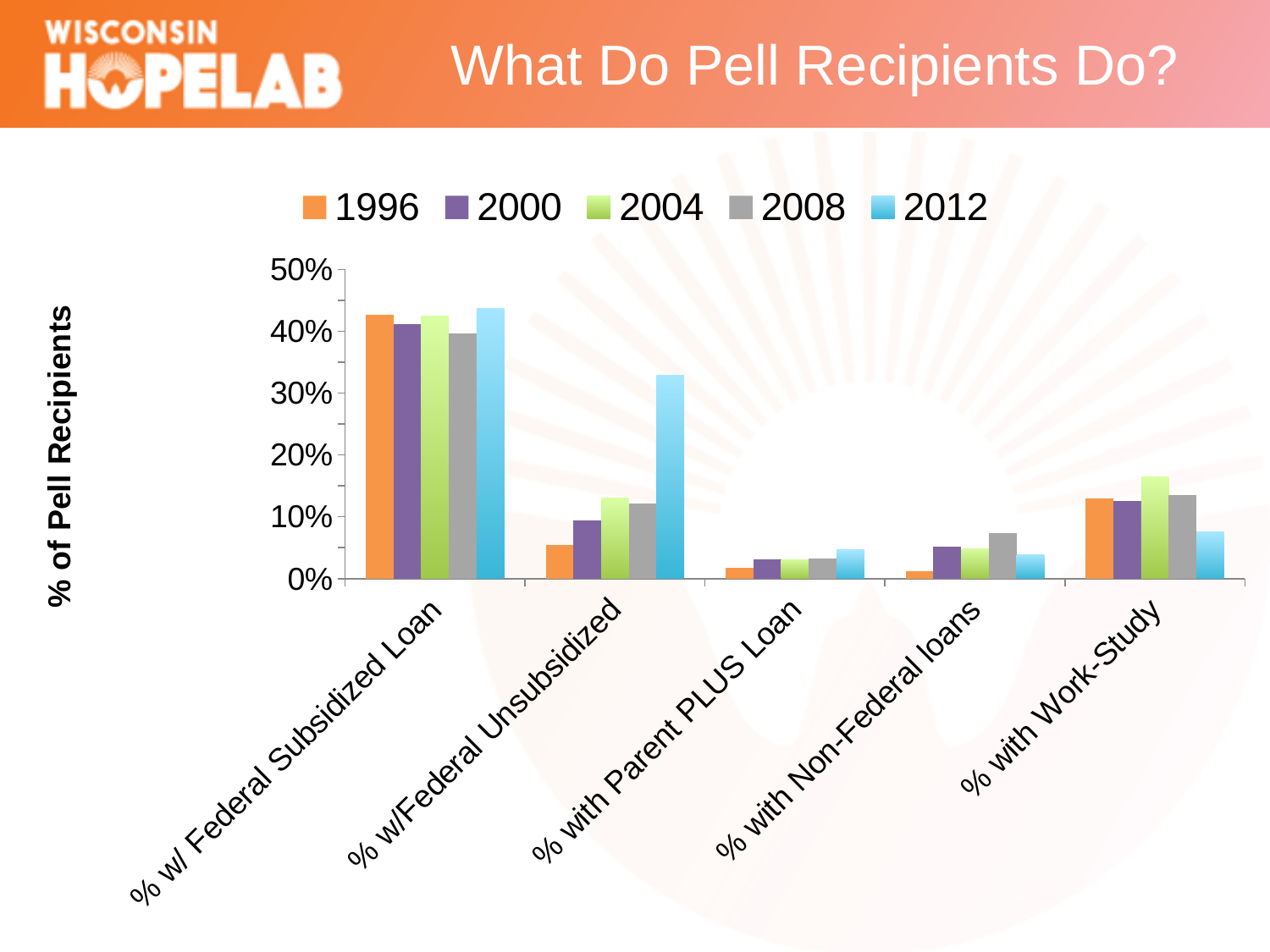
Is the 2012 value for % w/Federal Unsubsidized greater or less than 30%? greater What kind of chart is shown on the slide? bar chart Which year has the highest value for % with Non-Federal loans? 2008 What is the title of the vertical axis? % of Pell Recipients For % w/Federal Unsubsidized, which is larger: the 1996 value or the 2012 value? 2012 Does the value for % with Parent PLUS Loan rise or fall overall from 1996 to 2012? rise Is the 2004 value for % with Work-Study greater or less than 10%? greater Which year has the lowest value for % with Work-Study? 2012 Which category has the highest 2012 value? % w/ Federal Subsidized Loan How many series does the legend list? 5 How many categories are shown along the x axis? 5